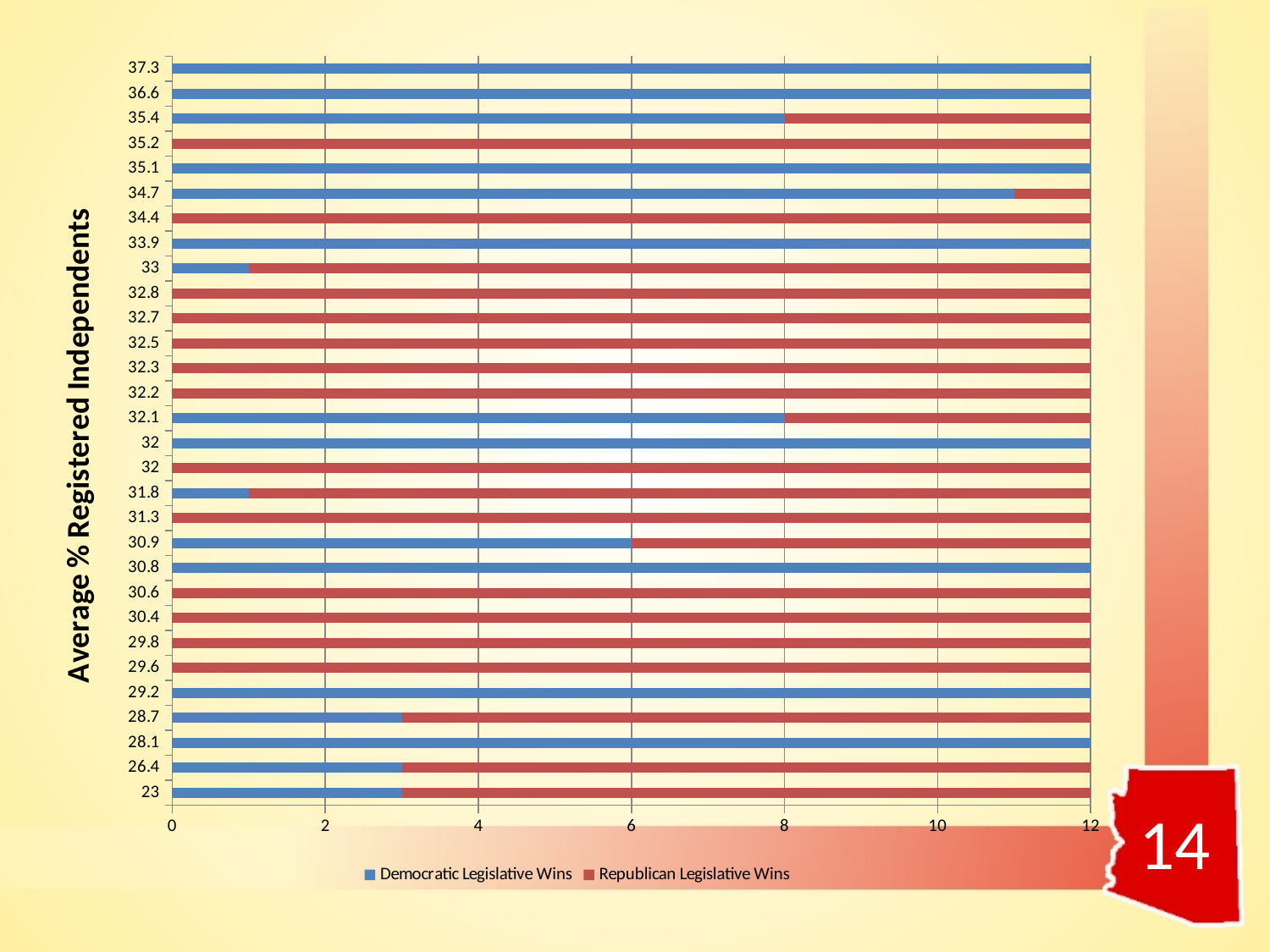
What is the value of Democratic Legislative Wins for the 35.4 category? 8 How many series does the legend list? 2 What is the total of the stacked bar for the 32.1 category? 12 What are the two series named in the legend? Democratic Legislative Wins and Republican Legislative Wins What is the title of the vertical axis? Average % Registered Independents What is the value of Democratic Legislative Wins for the 30.9 category? 6 Is the value of Democratic Legislative Wins for the 34.7 category greater or less than 10? greater Which has more Democratic Legislative Wins, the 35.4 category or the 30.9 category? 35.4 Is the value of Democratic Legislative Wins for the 28.7 category greater or less than 4? less What kind of chart is shown on the slide? Stacked bar chart What is the value of Democratic Legislative Wins for the 37.3 category? 12 How many categories are plotted on the vertical axis? 30